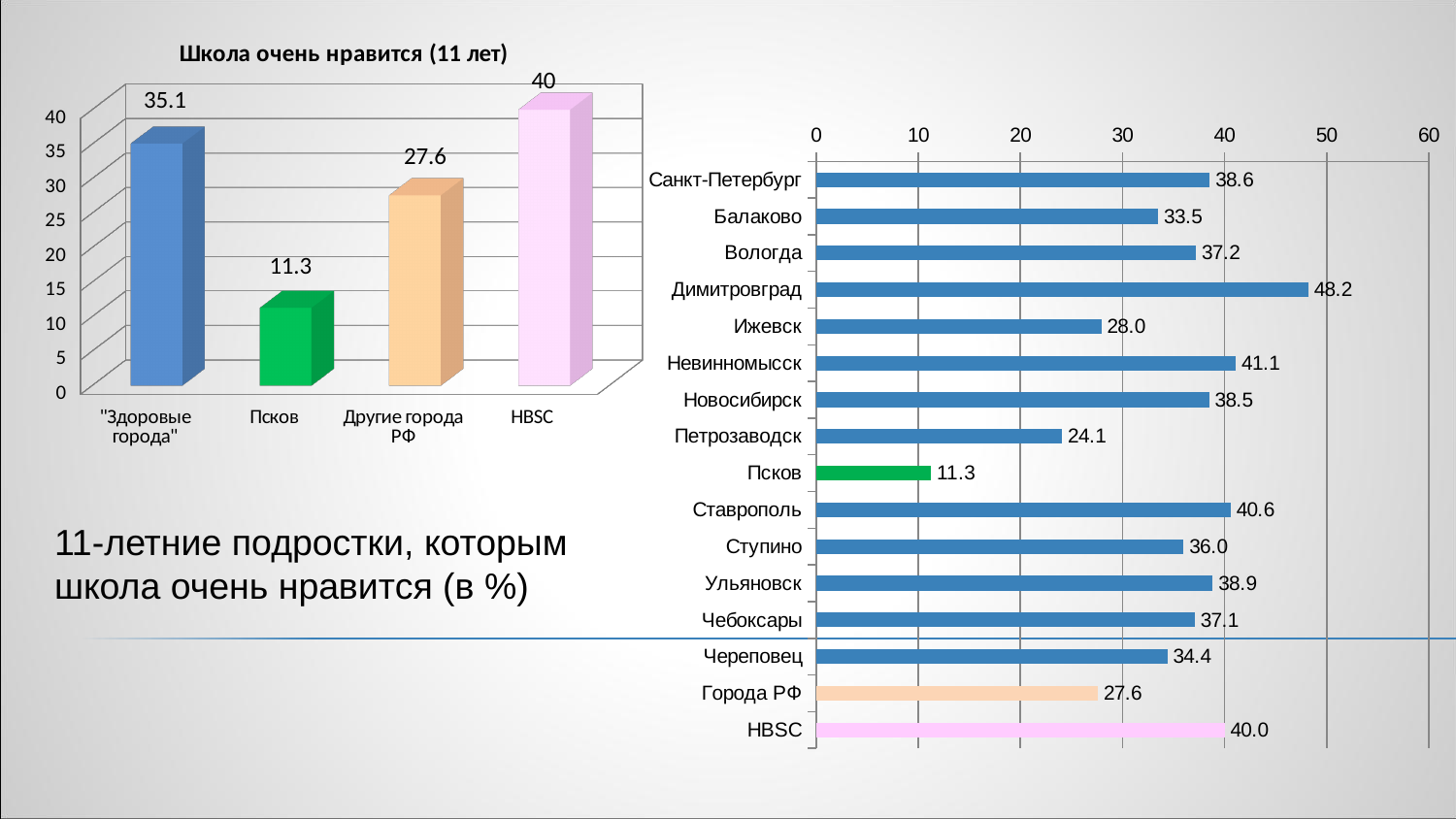
In the horizontal bar chart on the right, which city has the highest value? Димитровград In the left chart titled "Школа очень нравится (11 лет)", what is the difference between the HBSC value and the Псков value? 28.7 In the horizontal bar chart on the right, what is the value for Череповец? 34.4 What kind of chart is the chart on the right side of the slide? Bar chart In the horizontal bar chart on the right, which is larger: the value for Ставрополь or the value for Ступино? Ставрополь In the left chart titled "Школа очень нравится (11 лет)", how many bars are plotted? 4 In the left chart titled "Школа очень нравится (11 лет)", which category has the lowest value? Псков In the horizontal bar chart on the right, what is the value for Димитровград? 48.2 In the horizontal bar chart on the right, what is the difference between the values for Санкт-Петербург and Петрозаводск? 14.5 In the horizontal bar chart on the right, how many categories are plotted? 16 In the left chart titled "Школа очень нравится (11 лет)", what is the value for "Здоровые города"? 35.1 In the horizontal bar chart on the right, which category has the lowest value? Псков